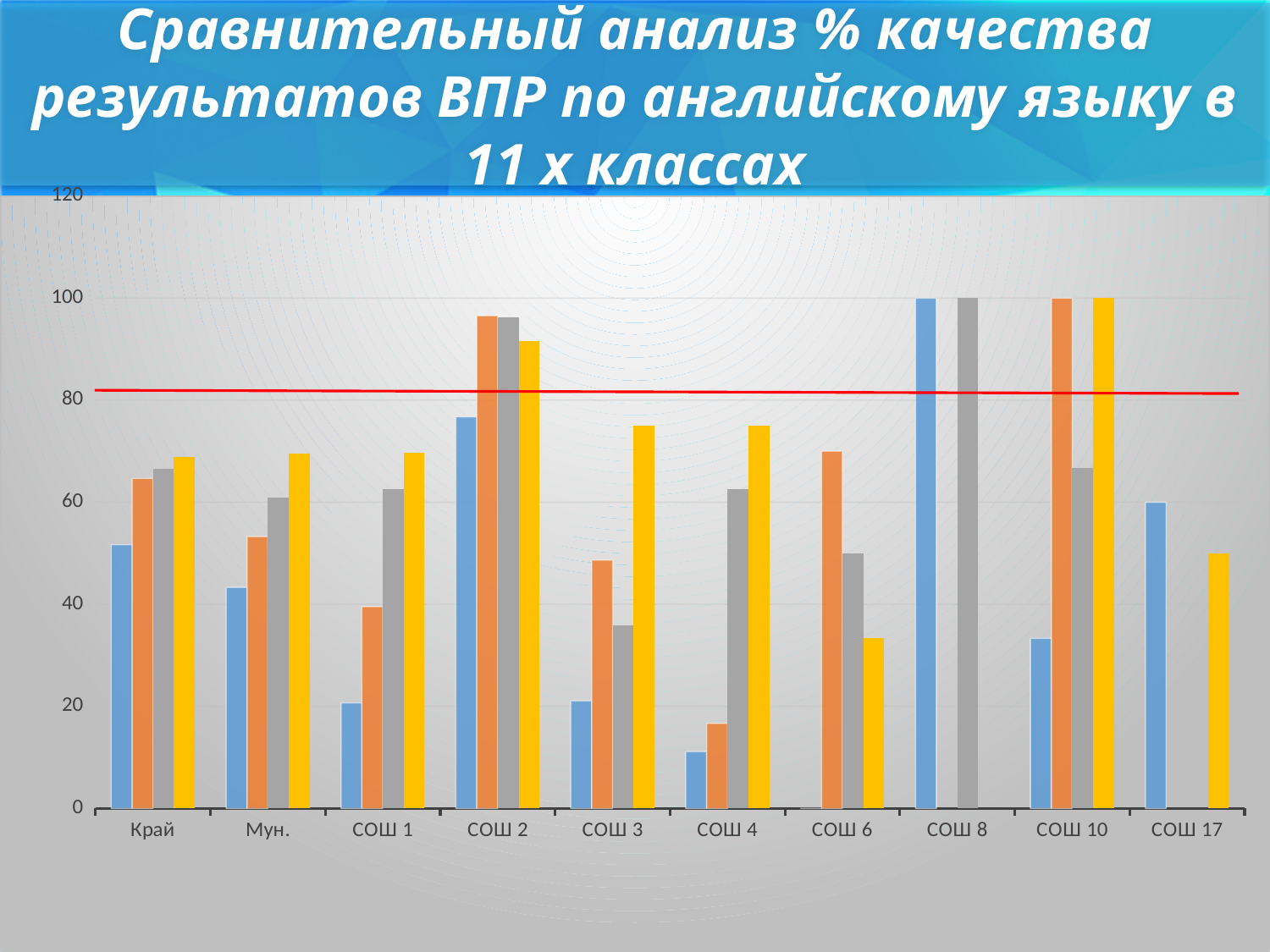
Which is larger: the blue bar for СОШ 2 or the blue bar for СОШ 3? СОШ 2 Is the value of the blue bar for СОШ 4 greater or less than 20? less Which is larger: the orange bar for Край or the orange bar for Мун.? Край Is the value of the yellow bar for СОШ 3 greater or less than 60? greater Is the value of the orange bar for СОШ 6 greater or less than 60? greater Which category has the highest blue bar? СОШ 8 What colour is the horizontal line drawn across the chart? red How many categories are shown along the x axis? 10 What kind of chart is shown on the slide? bar chart